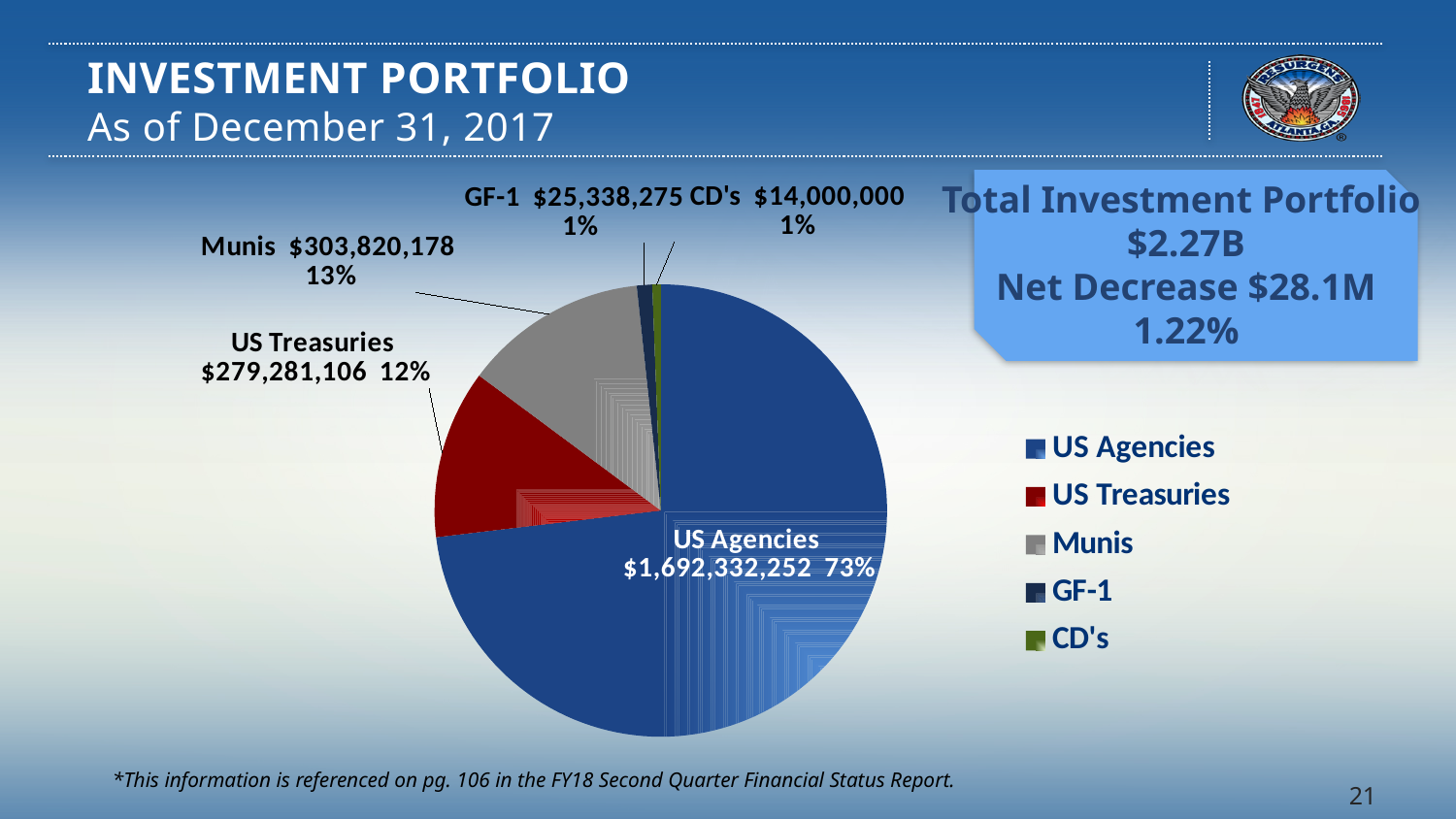
What share of the pie does US Agencies represent? 73% Which category has the smallest value in the pie chart? CD's What is the difference between the Munis value and the US Treasuries value? $24,539,072 What is the value for US Treasuries in the pie chart? $279,281,106 What is the value for Munis in the pie chart? $303,820,178 Which is larger, the value for GF-1 or the value for CD's? GF-1 What is the value for GF-1 in the pie chart? $25,338,275 What kind of chart is shown on the slide? pie chart How many categories does the legend of the pie chart list? 5 What is the value for US Agencies in the pie chart? $1,692,332,252 Which category has the largest slice of the pie? US Agencies What share of the pie does Munis represent? 13%